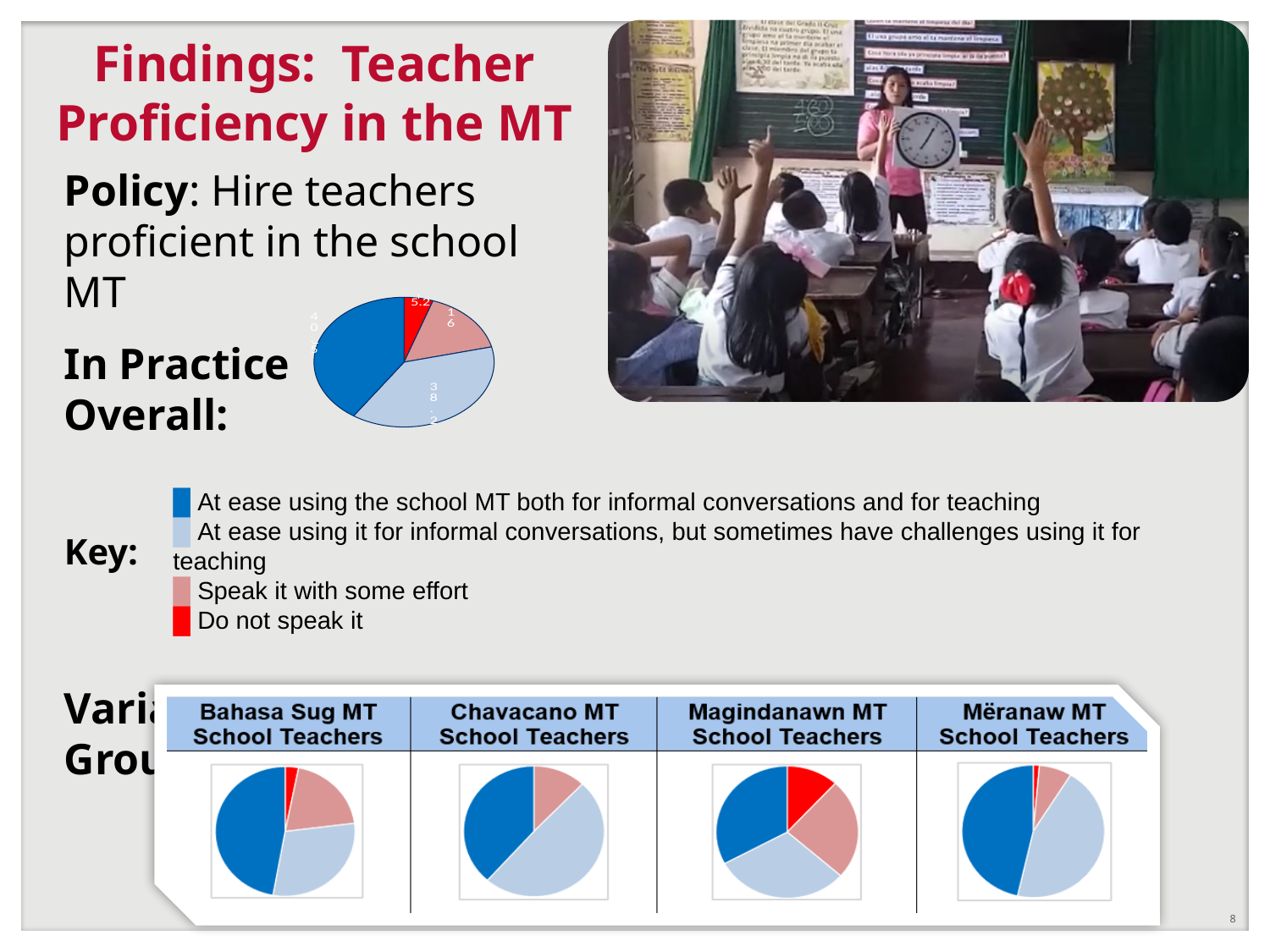
How many pie charts are shown in the row of school teacher groups at the bottom of the slide? 4 In the 'Mëranaw MT School Teachers' pie chart, which category has the largest slice? At ease using the school MT both for informal conversations and for teaching Which of the four school teacher group pie charts has no red 'Do not speak it' slice? Chavacano MT School Teachers In the 'Bahasa Sug MT School Teachers' pie chart, which category has the largest slice? At ease using the school MT both for informal conversations and for teaching In the 'In Practice Overall' pie chart, which slice is larger: 'Speak it with some effort' or 'Do not speak it'? Speak it with some effort In the 'In Practice Overall' pie chart, which category has the smallest slice? Do not speak it In the 'In Practice Overall' pie chart, what value is shown for the light blue slice (at ease for informal conversations but sometimes challenges teaching)? 38.2 In the 'Magindanawn MT School Teachers' pie chart, which category has the smallest slice? Do not speak it In the 'In Practice Overall' pie chart, what value is shown for the red 'Do not speak it' slice? 5.2 What kind of chart is the 'In Practice Overall' chart? pie chart How many slices does the 'Chavacano MT School Teachers' pie chart have? 3 How many categories does the key list for the pie charts? 4